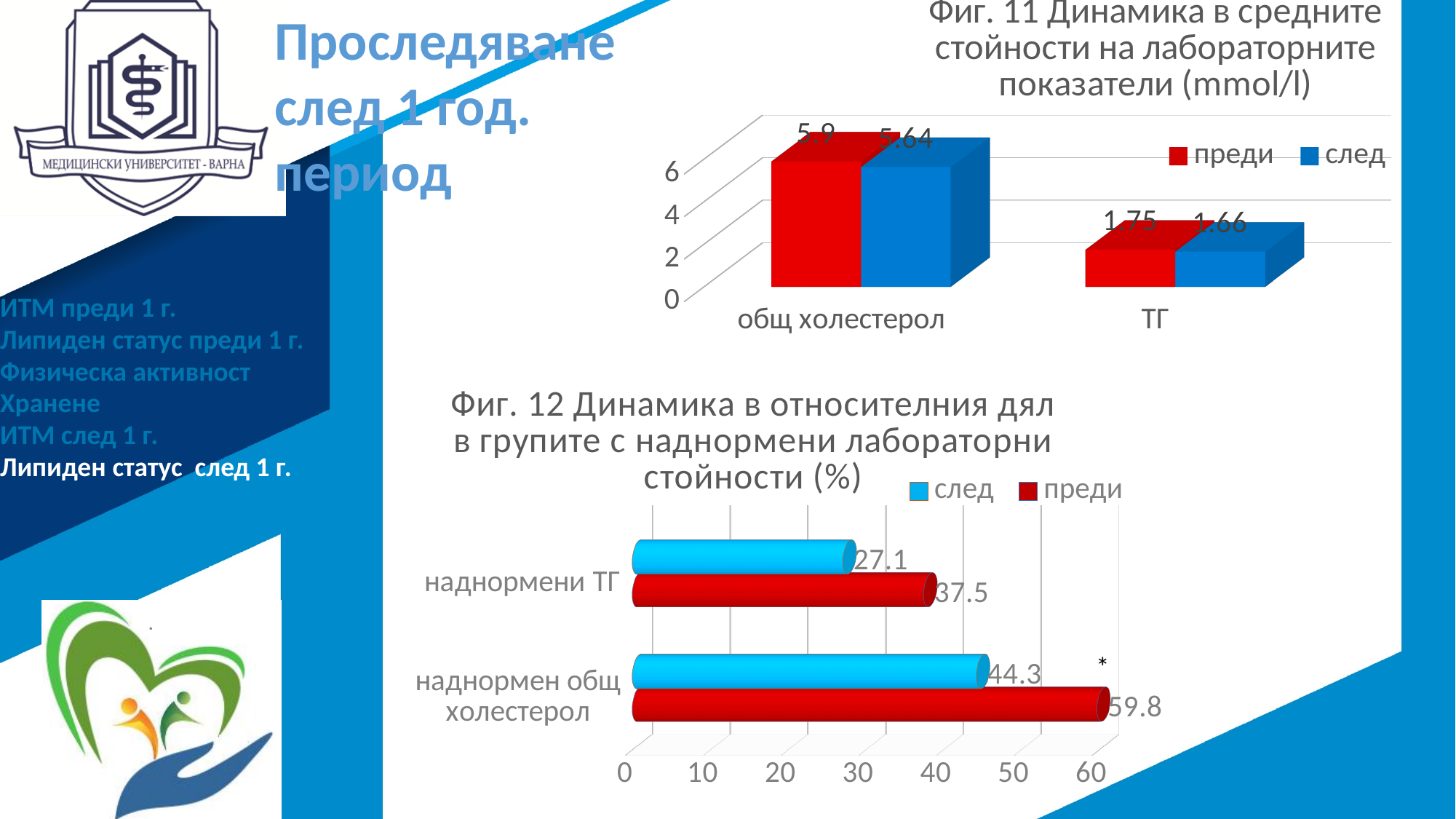
In the chart titled "Фиг. 11 Динамика в средните стойности на лабораторните показатели (mmol/l)", what is the value for "общ холестерол" in the "преди" series? 5.9 In the chart titled "Фиг. 11 Динамика в средните стойности на лабораторните показатели (mmol/l)", which category has the highest value in the "преди" series? общ холестерол In the chart titled "Фиг. 12 Динамика в относителния дял в групите с наднормени лабораторни стойности (%)", what is the value for "наднормен общ холестерол" in the "преди" series? 59.8 In the chart titled "Фиг. 12 Динамика в относителния дял в групите с наднормени лабораторни стойности (%)", which is larger: the "преди" value for "наднормени ТГ" or the "след" value for "наднормен общ холестерол"? след value for наднормен общ холестерол In the chart titled "Фиг. 11 Динамика в средните стойности на лабораторните показатели (mmol/l)", how many series does the legend list? 2 In the chart titled "Фиг. 11 Динамика в средните стойности на лабораторните показатели (mmol/l)", what is the value for "ТГ" in the "след" series? 1.66 In the chart titled "Фиг. 11 Динамика в средните стойности на лабораторните показатели (mmol/l)", which colour represents the "след" series? Blue In the chart titled "Фиг. 12 Динамика в относителния дял в групите с наднормени лабораторни стойности (%)", how many categories are shown? 2 In the chart titled "Фиг. 12 Динамика в относителния дял в групите с наднормени лабораторни стойности (%)", what kind of chart is shown? Bar chart In the chart titled "Фиг. 11 Динамика в средните стойности на лабораторните показатели (mmol/l)", what is the difference between the "преди" and "след" values for "общ холестерол"? 0.26 In the chart titled "Фиг. 12 Динамика в относителния дял в групите с наднормени лабораторни стойности (%)", what is the value for "наднормени ТГ" in the "след" series? 27.1 In the chart titled "Фиг. 12 Динамика в относителния дял в групите с наднормени лабораторни стойности (%)", what is the difference between the "преди" and "след" values for "наднормен общ холестерол"? 15.5